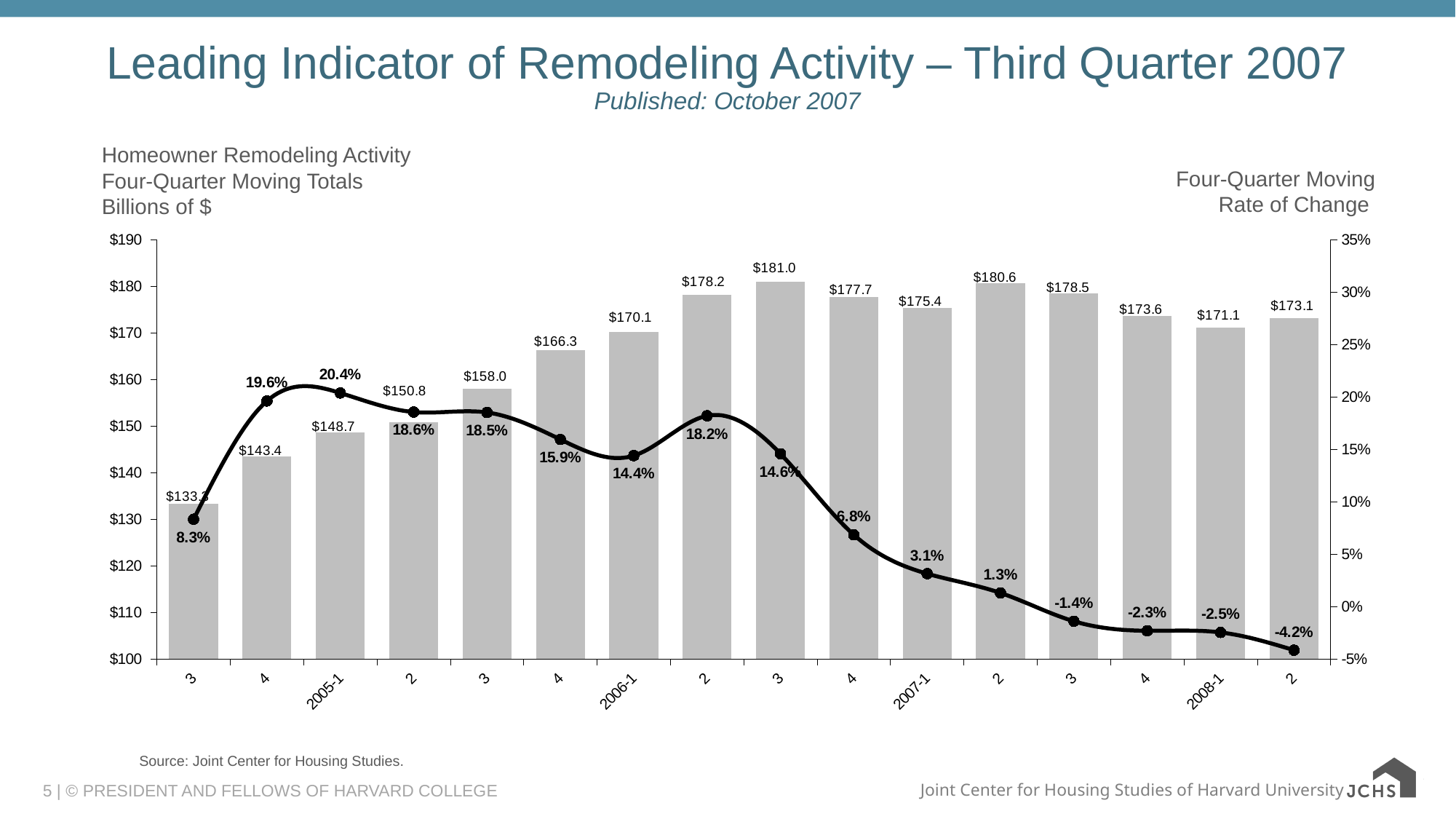
What kind of chart is shown on the slide? A bar chart combined with a line chart What is the four-quarter moving rate of change for 2007-1? 3.1% Is the four-quarter moving rate of change for 2008-1 greater or less than 0%? less How many percentage points higher is the rate of change for 2005-1 than for 2006-1? 6.0 percentage points What is the four-quarter moving total for 2006-1? $170.1 What is the difference between the four-quarter moving totals for 2007-1 and 2006-1? $5.3 What is the four-quarter moving rate of change for 2005-1? 20.4% Which quarter has the lowest four-quarter moving rate of change? The last quarter (2, after 2008-1), at -4.2% Which is larger, the four-quarter moving total for 2007-1 or for 2008-1? 2007-1 What is the four-quarter moving total for 2008-1? $171.1 How many quarters (bars) are plotted on the chart? 16 What is the highest four-quarter moving total shown on the chart? $181.0